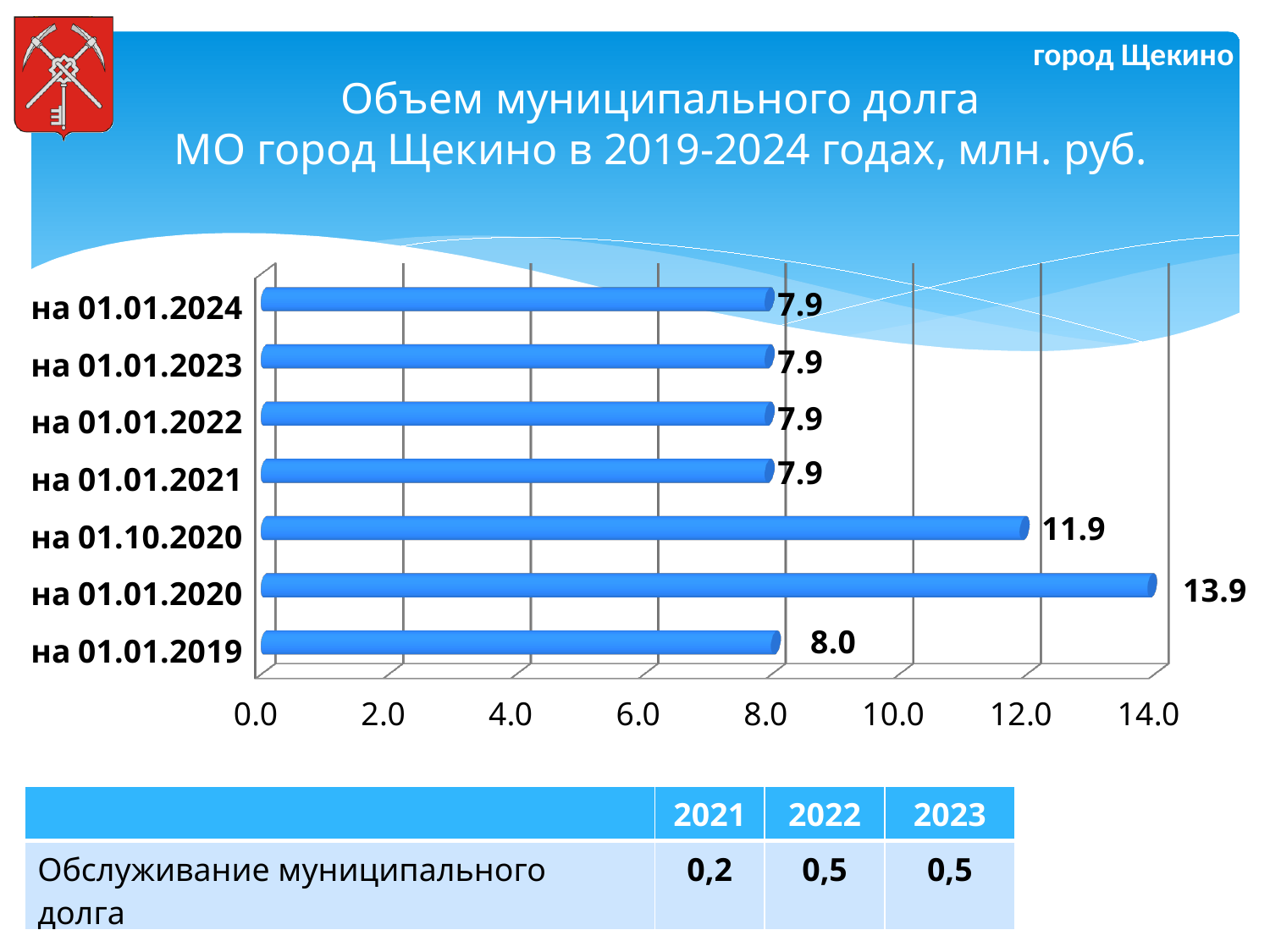
What is the value for на 01.10.2020? 11.9 What is the difference between the values for на 01.01.2020 and на 01.10.2020? 2.0 Is the value for на 01.10.2020 greater or less than 10.0? greater What is the value for на 01.01.2020? 13.9 What is the value for на 01.01.2019? 8.0 How many categories (dates) are shown in the chart? 7 Which category has the highest value? на 01.01.2020 What is the difference between the values for на 01.10.2020 and на 01.01.2021? 4.0 Which is larger, the value for на 01.10.2020 or the value for на 01.01.2019? на 01.10.2020 From на 01.01.2020 to на 01.01.2024, do the values rise or fall? fall What is the value for на 01.01.2024? 7.9 What kind of chart is shown on the slide? bar chart